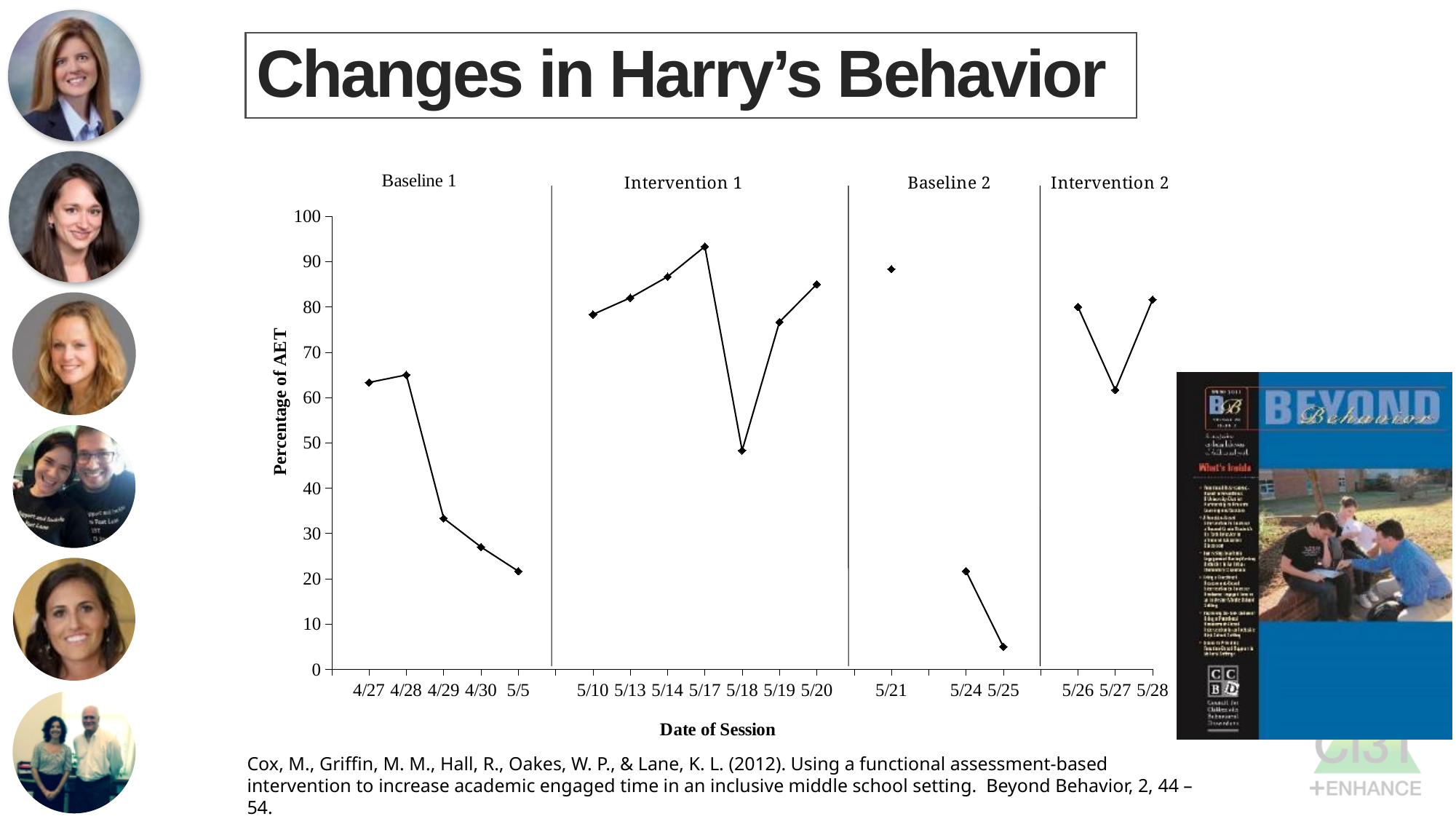
What kind of chart is shown on the slide? line chart Is the value for 5/25 greater or less than 10? less Does the percentage of AET rise or fall across the Baseline 1 phase from 4/27 to 5/5? fall On which session date is the percentage of AET lowest? 5/25 What is the title of the x axis of the chart? Date of Session Is the value for 5/18 greater or less than 60? less Which session date has the higher percentage of AET, 5/21 or 5/24? 5/21 Which session date has the higher percentage of AET, 4/28 or 4/29? 4/28 Is the value for 4/27 greater or less than 50? greater What is the title of the y axis of the chart? Percentage of AET On which session date is the percentage of AET highest? 5/17